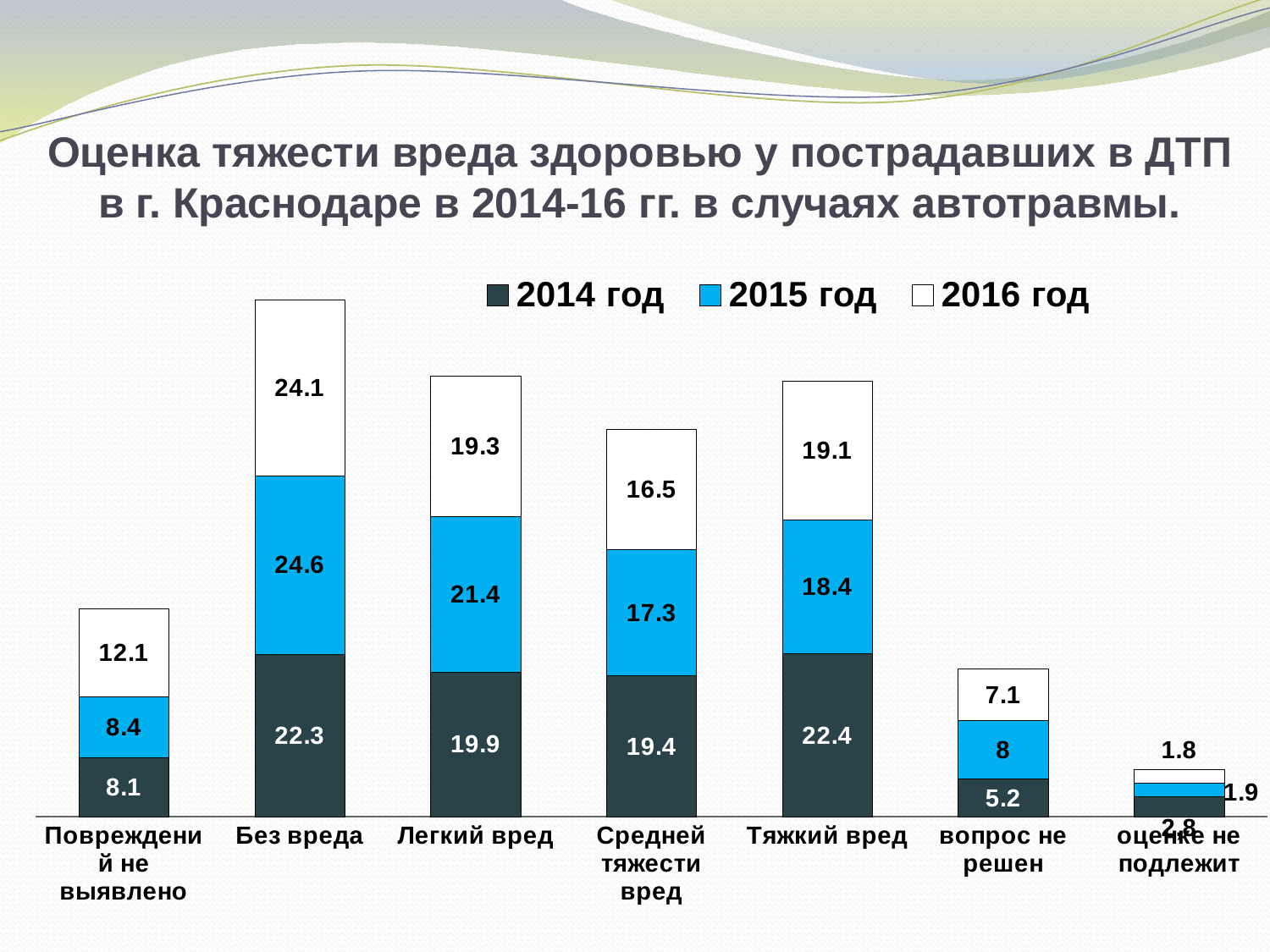
What is the difference between the 2015 год and 2016 год values for Средней тяжести вред? 0.8 What is the value for 2015 год in the category Без вреда? 24.6 How many series does the legend list? 3 What kind of chart is shown on the slide? stacked bar chart Which series is shown in white in the legend? 2016 год How many categories are shown along the x axis? 7 Which is larger: the 2015 год value for Легкий вред or the 2015 год value for Тяжкий вред? Легкий вред What is the total of the stacked bar for Тяжкий вред? 59.9 What is the value for 2016 год in the category Повреждений не выявлено? 12.1 Which category has the highest value for 2016 год? Без вреда Which category has the tallest stacked bar overall? Без вреда What is the value for 2014 год in the category Тяжкий вред? 22.4